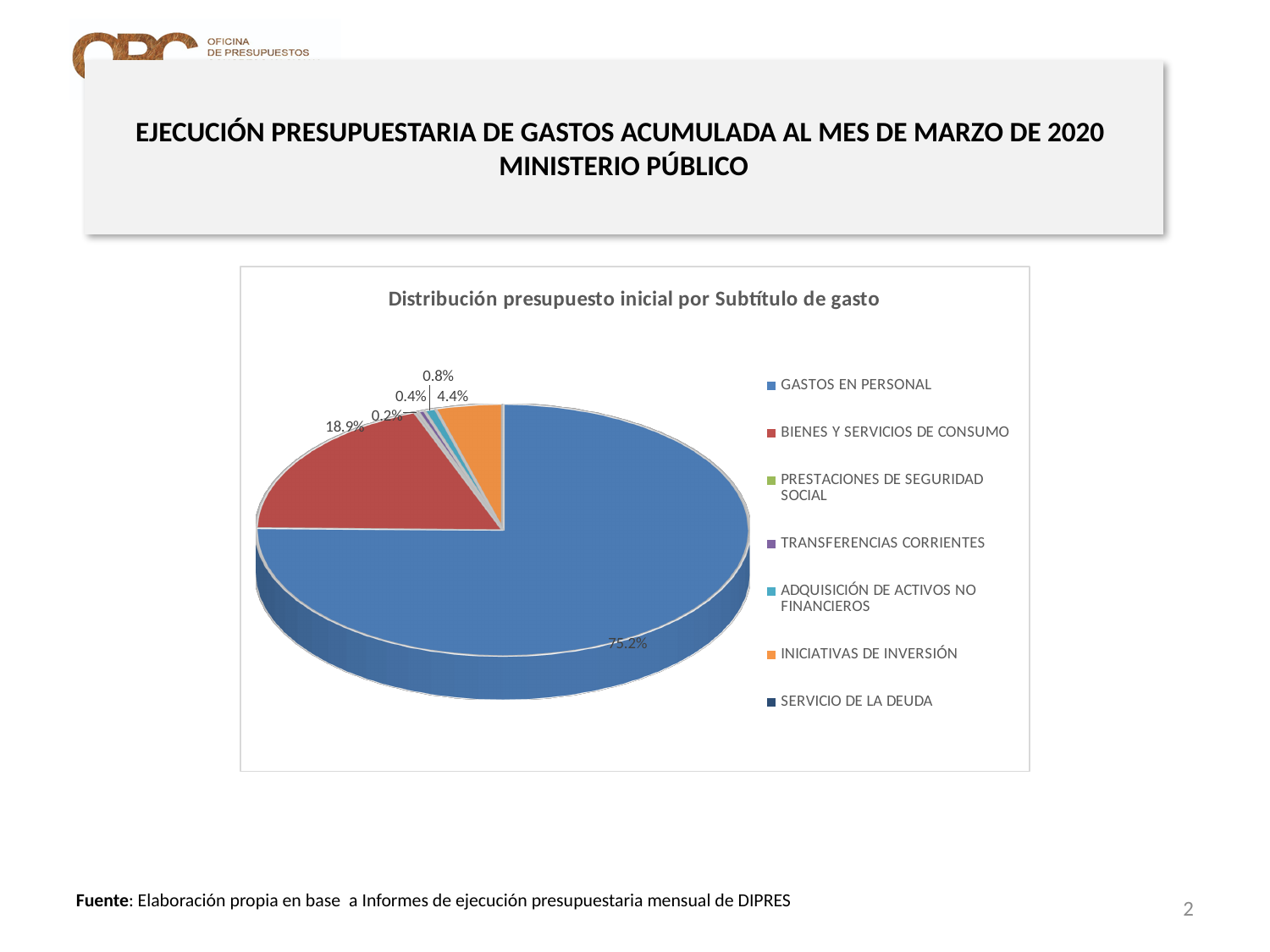
What share of the pie does GASTOS EN PERSONAL represent? 75.2% What is the title of the chart? Distribución presupuesto inicial por Subtítulo de gasto What kind of chart is shown on the slide? Pie chart How many categories does the legend list? 7 What is the combined share of GASTOS EN PERSONAL and BIENES Y SERVICIOS DE CONSUMO? 94.1% Which is larger, the share for BIENES Y SERVICIOS DE CONSUMO or the share for INICIATIVAS DE INVERSIÓN? BIENES Y SERVICIOS DE CONSUMO What is the difference in percentage points between GASTOS EN PERSONAL and BIENES Y SERVICIOS DE CONSUMO? 56.3 percentage points What colour is the slice for GASTOS EN PERSONAL? Blue What share of the pie does BIENES Y SERVICIOS DE CONSUMO represent? 18.9% What share of the pie does INICIATIVAS DE INVERSIÓN represent? 4.4% Which category has the largest slice of the pie? GASTOS EN PERSONAL Is the share for GASTOS EN PERSONAL greater or less than 50%? greater